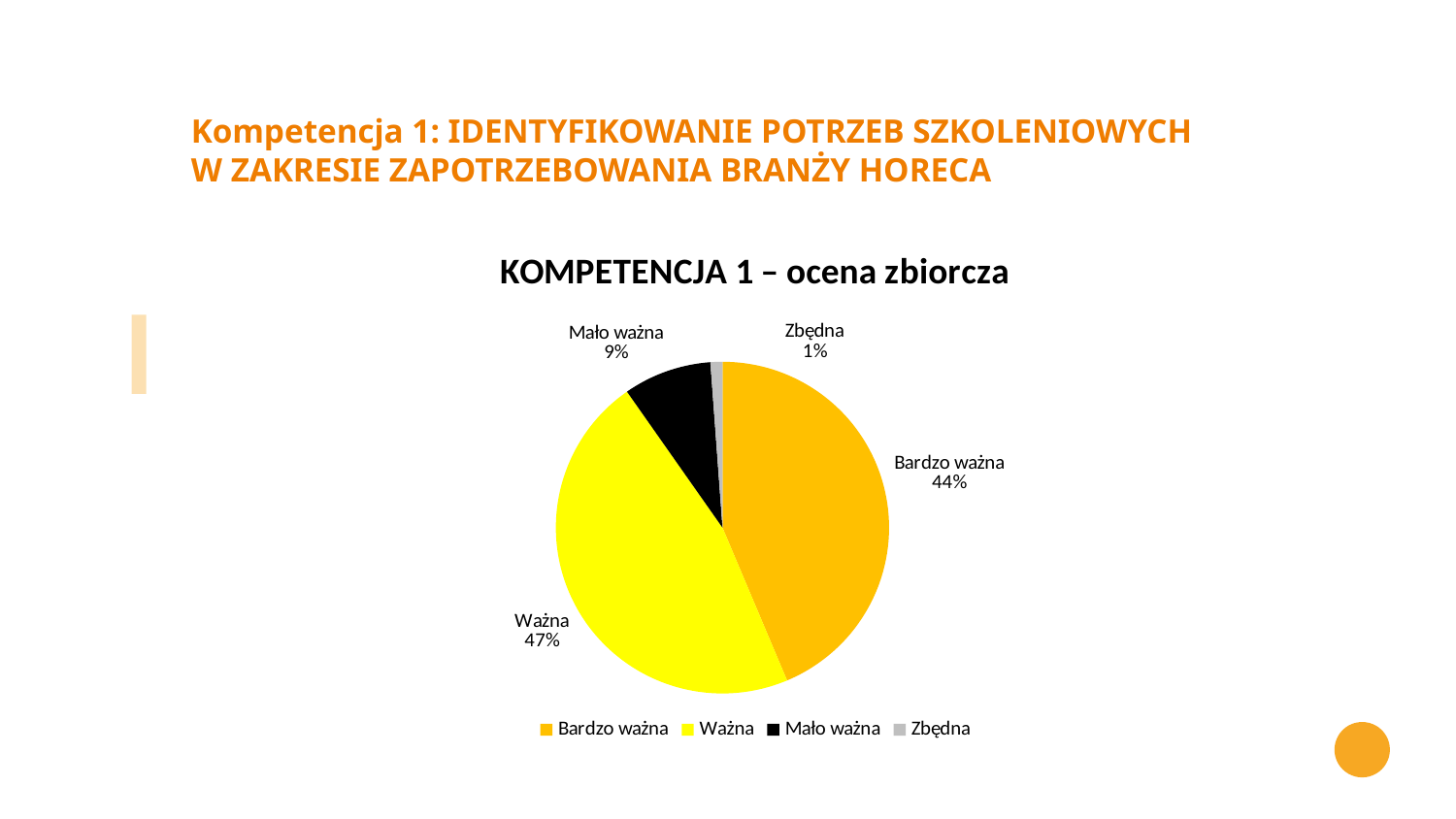
What percentage of the pie is labelled "Bardzo ważna"? 44% What percentage of the pie is labelled "Zbędna"? 1% What percentage of the pie is labelled "Mało ważna"? 9% How many slices does the pie chart have? 4 Which colour represents "Mało ważna" in the legend? black What is the difference in percentage points between "Ważna" and "Bardzo ważna"? 3 Which is larger, the share for "Mało ważna" or the share for "Zbędna"? Mało ważna Which category has the smallest share of the pie? Zbędna What is the title of the chart? KOMPETENCJA 1 – ocena zbiorcza Which category has the largest share of the pie? Ważna What percentage of the pie is labelled "Ważna"? 47% What kind of chart is shown on the slide? pie chart